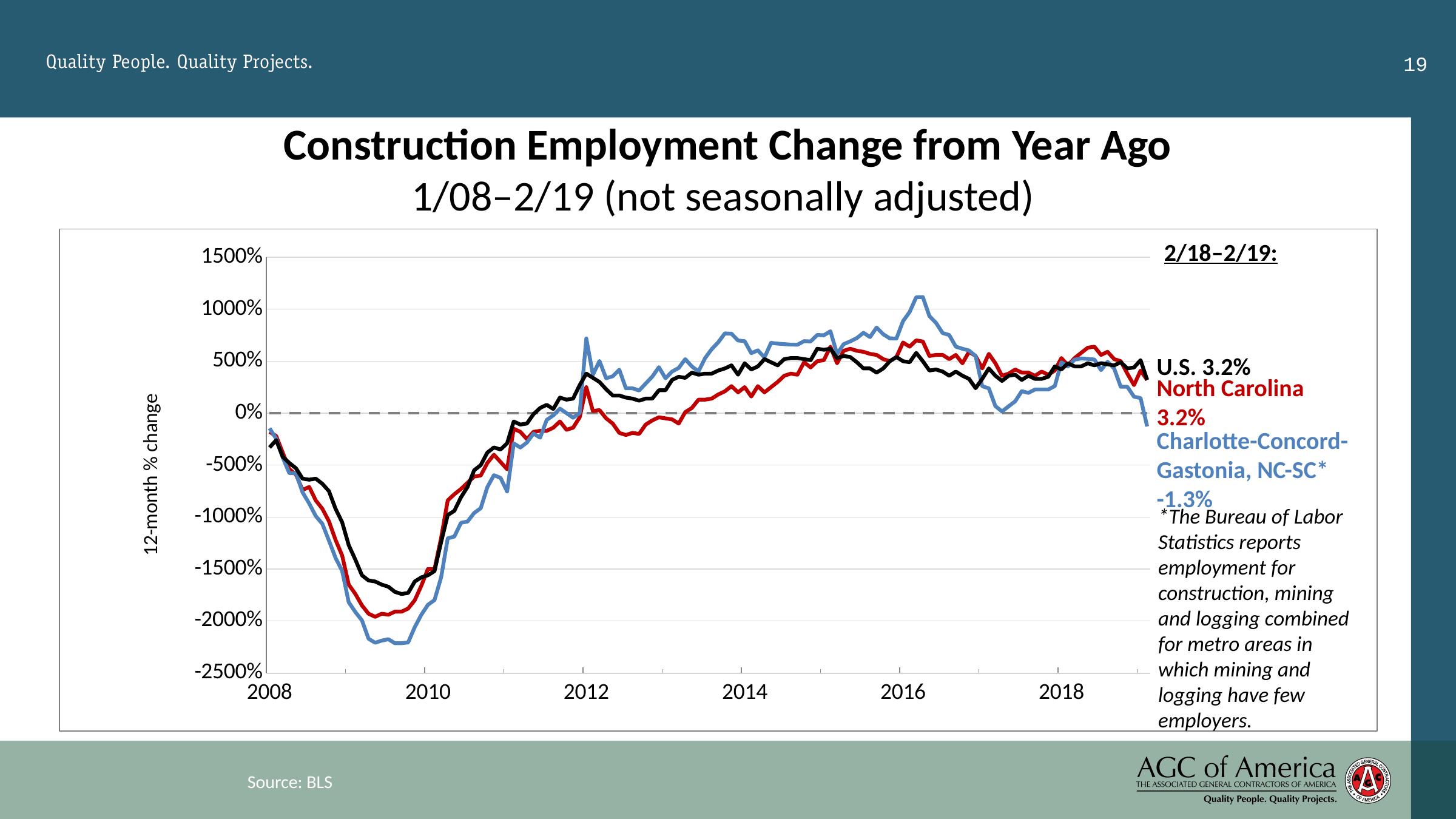
How many series are plotted on the chart? 3 Which colour is used for the North Carolina line? red What is the label on the vertical axis? 12-month % change What type of chart is shown on the slide? line chart What is the 2/18–2/19 construction employment change for Charlotte-Concord-Gastonia, NC-SC? -1.3% Which of the three areas has the lowest 2/18–2/19 employment change? Charlotte-Concord-Gastonia, NC-SC Is the 2/18–2/19 value for the U.S. larger or smaller than the value for Charlotte-Concord-Gastonia, NC-SC? larger What is the difference between the 2/18–2/19 values for North Carolina and Charlotte-Concord-Gastonia, NC-SC? 4.5 percentage points What is the 2/18–2/19 construction employment change for the U.S.? 3.2% Is the highest point of the Charlotte-Concord-Gastonia line, around 2016, greater or less than 1000%? greater What is the 2/18–2/19 construction employment change for North Carolina? 3.2% Is the lowest point of the Charlotte-Concord-Gastonia line, around 2009, greater or less than -2000%? less